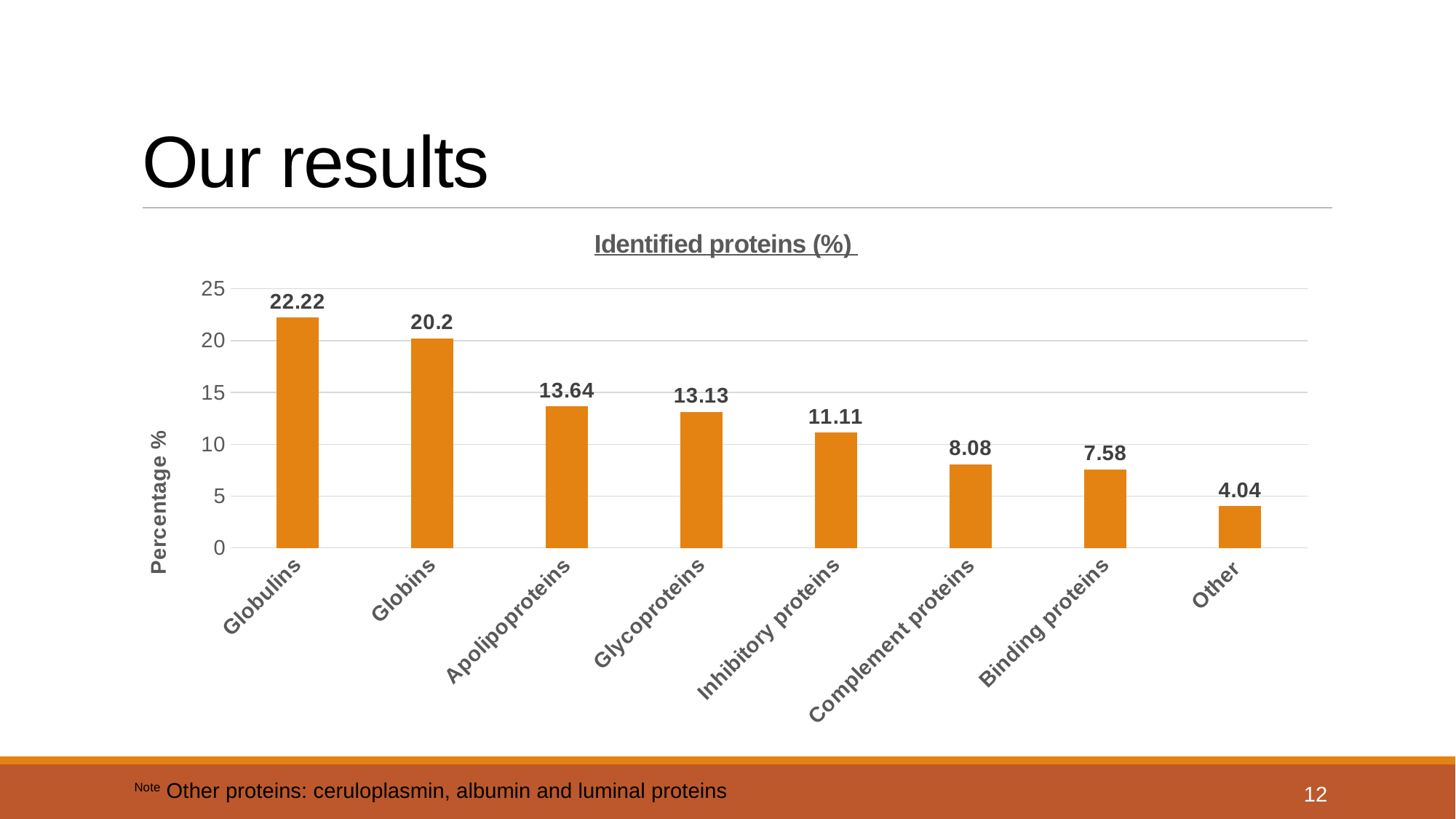
What is the value for Complement proteins? 8.08 Which is larger, the value for Glycoproteins or the value for Inhibitory proteins? Glycoproteins What is the title of the chart? Identified proteins (%) Which category has the lowest value? Other What kind of chart is shown on the slide? bar chart What is the value for Apolipoproteins? 13.64 How many categories are shown on the x axis? 8 What is the difference between the values for Inhibitory proteins and Binding proteins? 3.53 What is the difference between the values for Globulins and Globins? 2.02 Is the value for Binding proteins greater or less than 10? less Which category has the highest value? Globulins What is the value for Globulins? 22.22